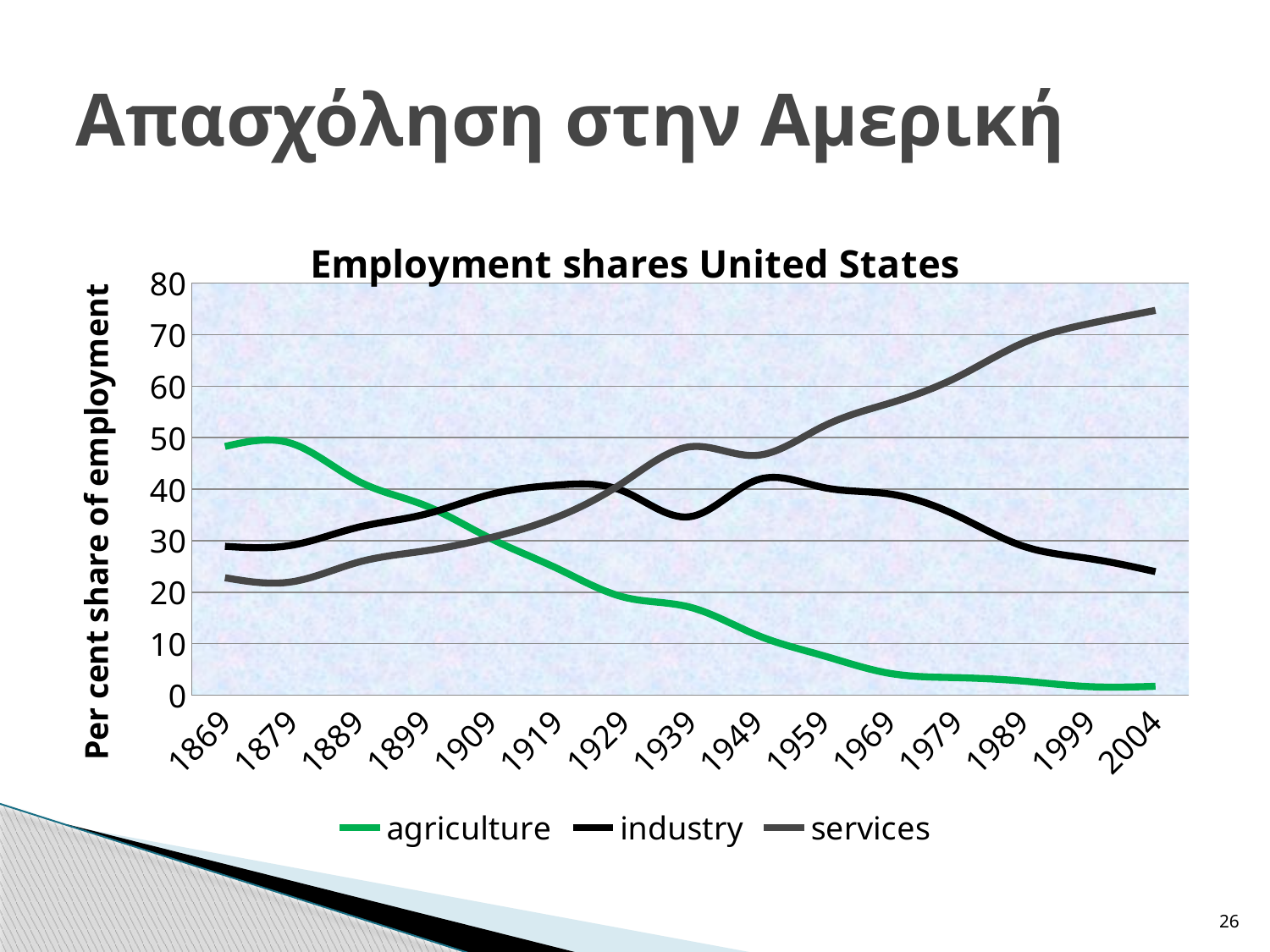
How many series does the legend list? 3 Does the agriculture series rise or fall from 1869 to 2004? fall What is the label of the vertical axis? Per cent share of employment Which series has the highest value in 1869? agriculture Is the value for services in 2004 greater or less than 70? greater Which series has the lowest value in 2004? agriculture Does the services series rise or fall from 1869 to 2004? rise Which series has the highest value in 2004? services Is the value for industry in 2004 greater or less than 30? less What kind of chart is shown on the slide? line chart What is the title of the chart? Employment shares United States How many years are labelled on the x axis? 15